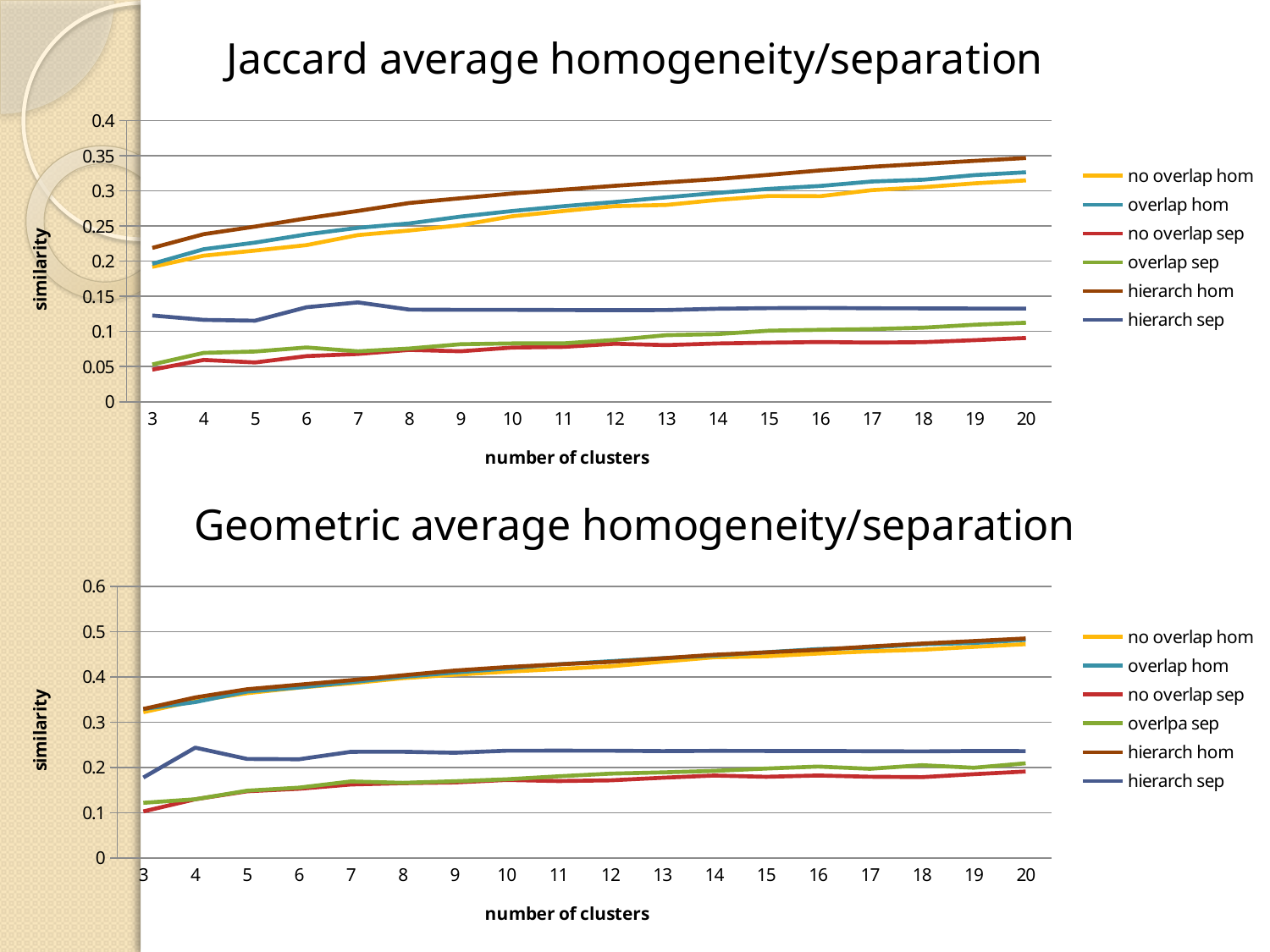
In the 'Jaccard average homogeneity/separation' chart, which is larger at 20 clusters: 'hierarch hom' or 'no overlap hom'? hierarch hom In the 'Jaccard average homogeneity/separation' chart, is the value of 'no overlap sep' at 3 clusters greater or less than 0.1? less In the 'Geometric average homogeneity/separation' chart, which series has the lowest value at 3 clusters? no overlap sep In the 'Jaccard average homogeneity/separation' chart, which series has the highest value at 20 clusters? hierarch hom How many values of 'number of clusters' are plotted along the x axis of the 'Jaccard average homogeneity/separation' chart? 18 In the 'Jaccard average homogeneity/separation' chart, is the value of 'hierarch hom' at 20 clusters greater or less than 0.3? greater What is the label of the y axis on the 'Geometric average homogeneity/separation' chart? similarity In the 'Geometric average homogeneity/separation' chart, is the value of 'hierarch hom' at 20 clusters greater or less than 0.4? greater What kind of chart is the 'Jaccard average homogeneity/separation' chart? line chart In the 'Jaccard average homogeneity/separation' chart, which series has the lowest value at 20 clusters? no overlap sep In the 'Jaccard average homogeneity/separation' chart, does the 'hierarch hom' series rise or fall as the number of clusters increases? rise How many series does the legend of the 'Jaccard average homogeneity/separation' chart list? 6